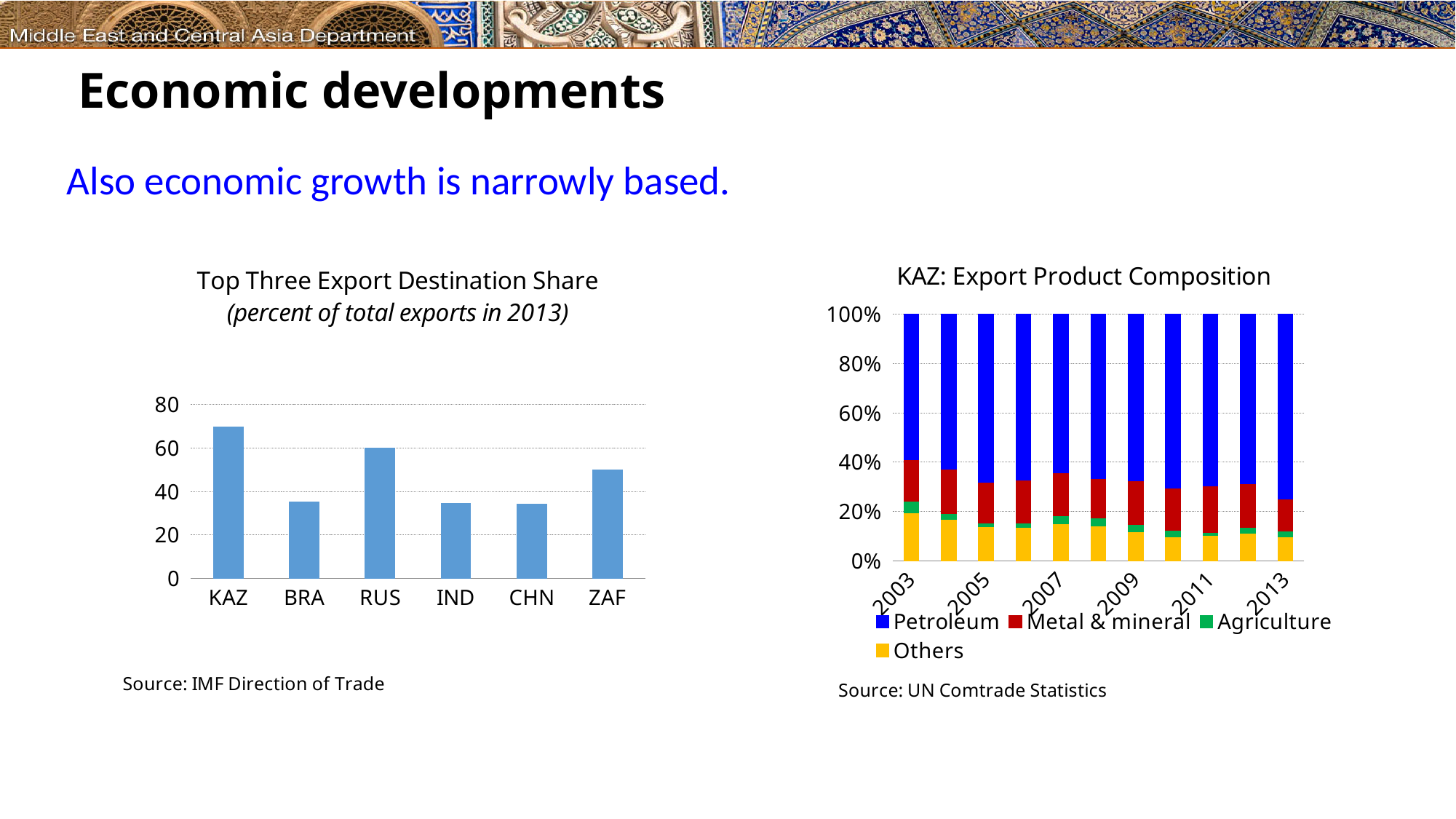
In the 'Top Three Export Destination Share' chart, which is larger, the value for KAZ or the value for RUS? KAZ In the 'KAZ: Export Product Composition' chart, is the Petroleum share in 2013 greater or less than 60%? greater In the 'Top Three Export Destination Share' chart, is the value for KAZ greater or less than 60? greater In the 'Top Three Export Destination Share' chart, which country has the highest value? KAZ What kind of chart is the 'Top Three Export Destination Share' chart on the left? bar chart In the 'Top Three Export Destination Share' chart, how many countries are shown on the x axis? 6 In the 'KAZ: Export Product Composition' chart, how many series does the legend list? 4 In the 'KAZ: Export Product Composition' chart, does the Petroleum share rise or fall from 2003 to 2013? rise In the 'Top Three Export Destination Share' chart, is the value for ZAF greater or less than 40? greater In the 'KAZ: Export Product Composition' chart, which series is shown in blue? Petroleum In the 'KAZ: Export Product Composition' chart, how many stacked bars are plotted? 11